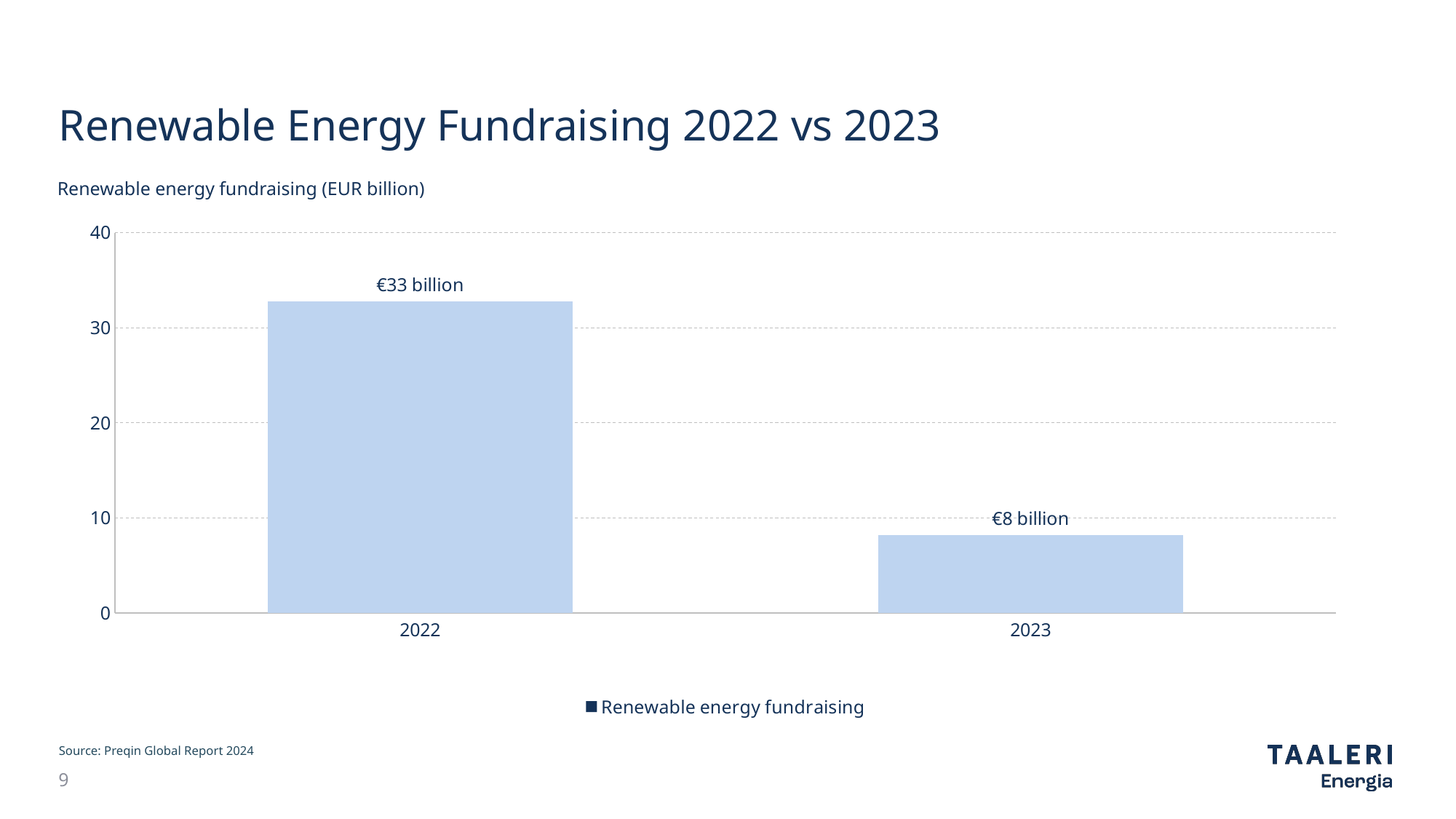
What is the difference between the 2022 and 2023 renewable energy fundraising values? €25 billion Is the value for 2023 greater or less than 10? less Which year has the lowest renewable energy fundraising? 2023 What is the renewable energy fundraising value for 2022? €33 billion Do the values rise or fall from 2022 to 2023? fall Which is larger, the fundraising value for 2022 or for 2023? 2022 Is the value for 2022 greater or less than 30? greater How many series does the legend list? 1 What kind of chart is shown on the slide? bar chart Which year has the highest renewable energy fundraising? 2022 What is the renewable energy fundraising value for 2023? €8 billion How many years are shown on the x axis of the chart? 2